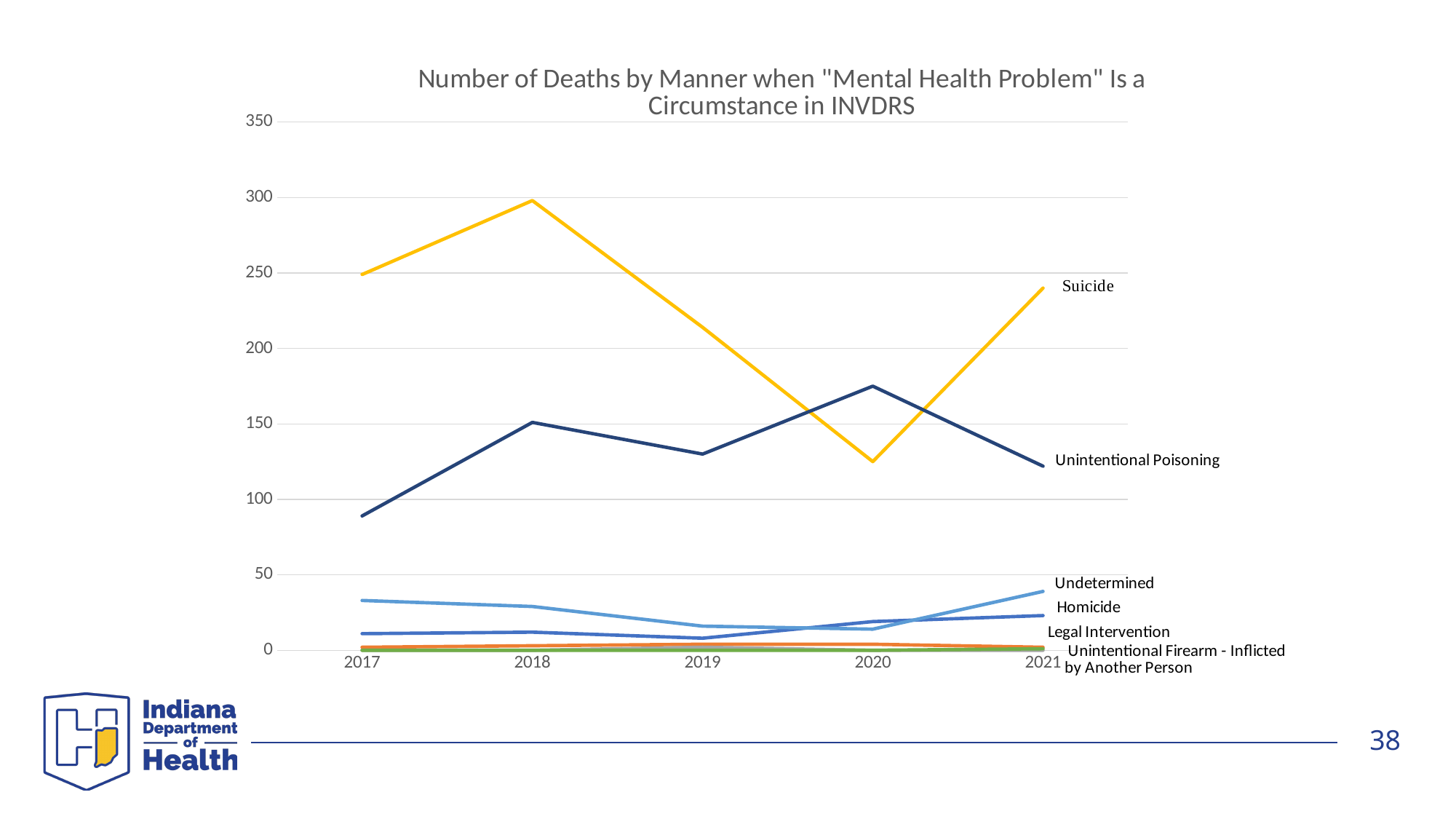
In which year does the Suicide line reach its lowest value? 2020 Is the value for Suicide in 2018 greater or less than 250? greater Does the Suicide line rise or fall from 2018 to 2020? fall Which series is labelled with the yellow line? Suicide In 2020, which is larger: Suicide or Unintentional Poisoning? Unintentional Poisoning In which year does the Suicide line reach its highest value? 2018 What kind of chart is shown on the slide? line chart In which year does the Unintentional Poisoning line reach its highest value? 2020 How many years are plotted along the x axis? 5 Is the value for Suicide in 2020 greater or less than 150? less How many series are labelled on the chart? 6 Is the value for Unintentional Poisoning in 2017 greater or less than 100? less